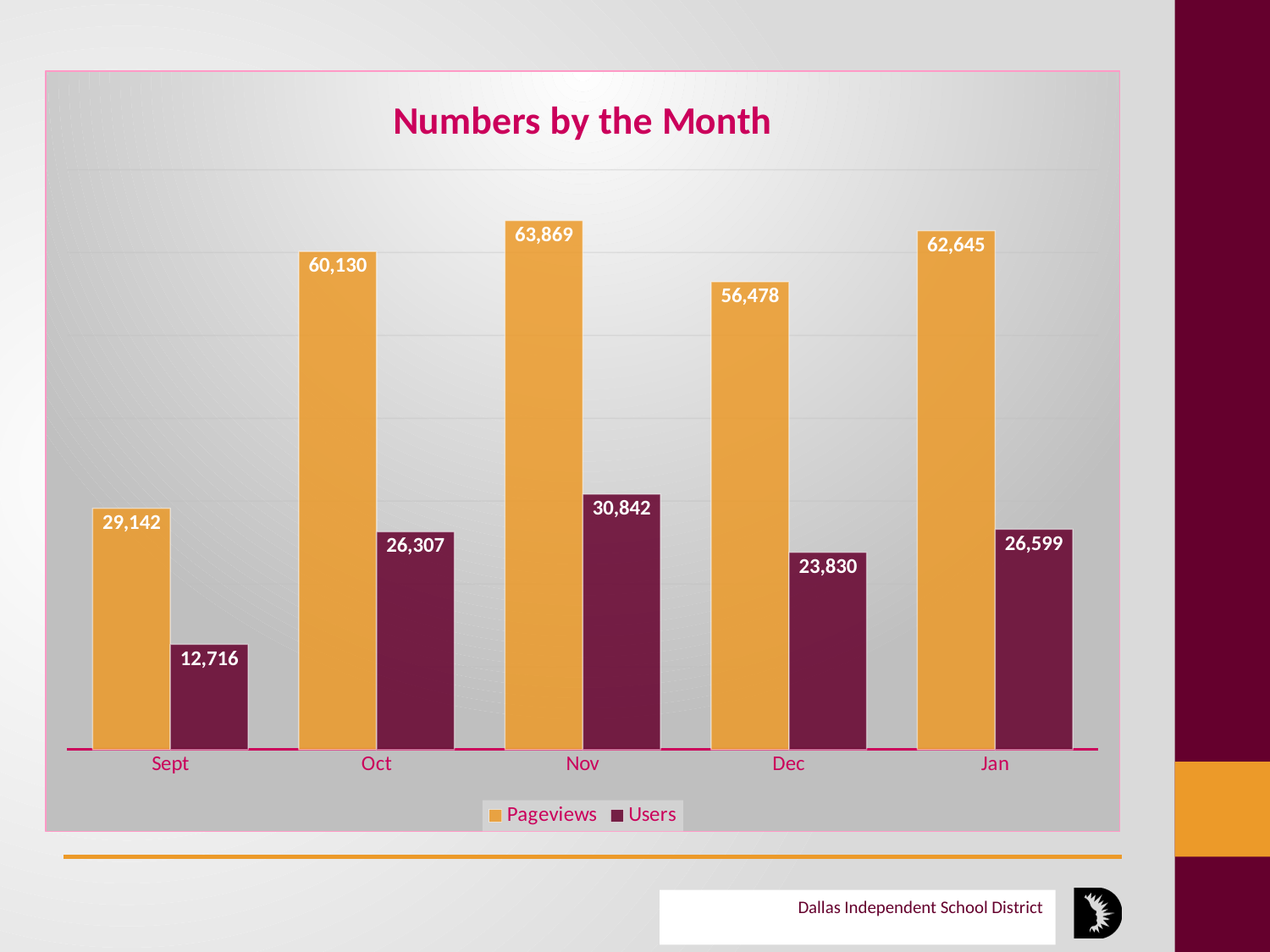
How many months are shown on the x axis? 5 What is the Users value for Sept? 12,716 Which month has the highest Pageviews? Nov Which is larger, Pageviews in Oct or Pageviews in Jan? Jan How many series does the legend list? 2 What is the difference between Users in Jan and Users in Oct? 292 What is the Pageviews value for Nov? 63,869 What is the title of the chart? Numbers by the Month What kind of chart is shown? Bar chart What is the difference between Pageviews in Nov and Pageviews in Dec? 7,391 Which month has the lowest Users value? Sept What is the Users value for Dec? 23,830